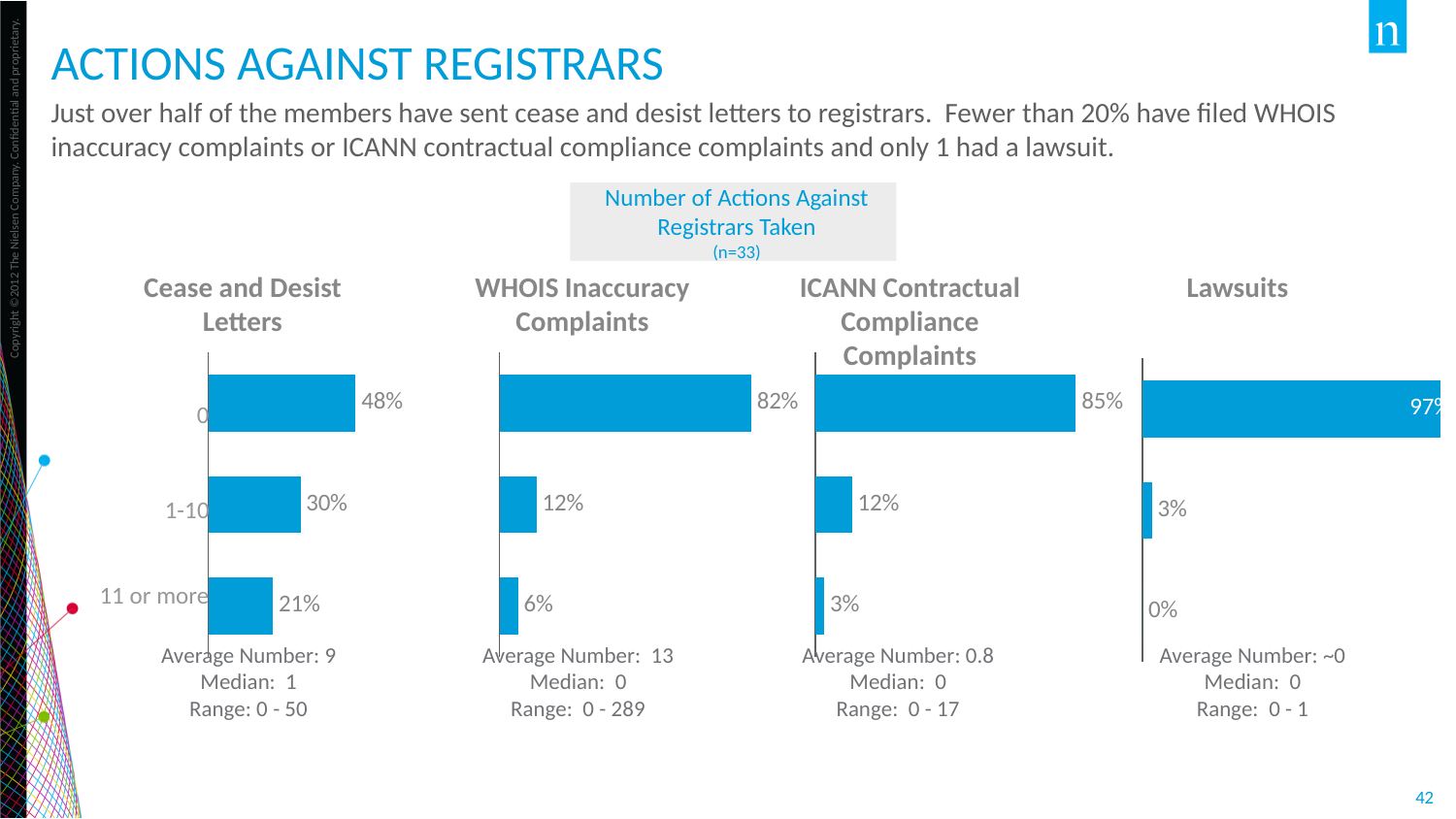
What type of chart is used for the Cease and Desist Letters data? Bar chart In the WHOIS Inaccuracy Complaints chart, what is the difference between the 1-10 and 11 or more categories? 6% How many categories does each of the four charts show? 3 In the Cease and Desist Letters chart, what is the difference between the 0 category and the 1-10 category? 18% In the ICANN Contractual Compliance Complaints chart, what is the value for the 0 category? 85% In the Cease and Desist Letters chart, which category has the highest value? 0 In the ICANN Contractual Compliance Complaints chart, which category has the lowest value? 11 or more Which is larger: the 1-10 value in the Cease and Desist Letters chart or the 1-10 value in the Lawsuits chart? Cease and Desist Letters In the Lawsuits chart, what is the value for the 11 or more category? 0% In the Cease and Desist Letters chart, what percentage of members sent 0 letters? 48% In the WHOIS Inaccuracy Complaints chart, what percentage of members filed 1-10 complaints? 12% In the Cease and Desist Letters chart, what is the value for the 11 or more category? 21%